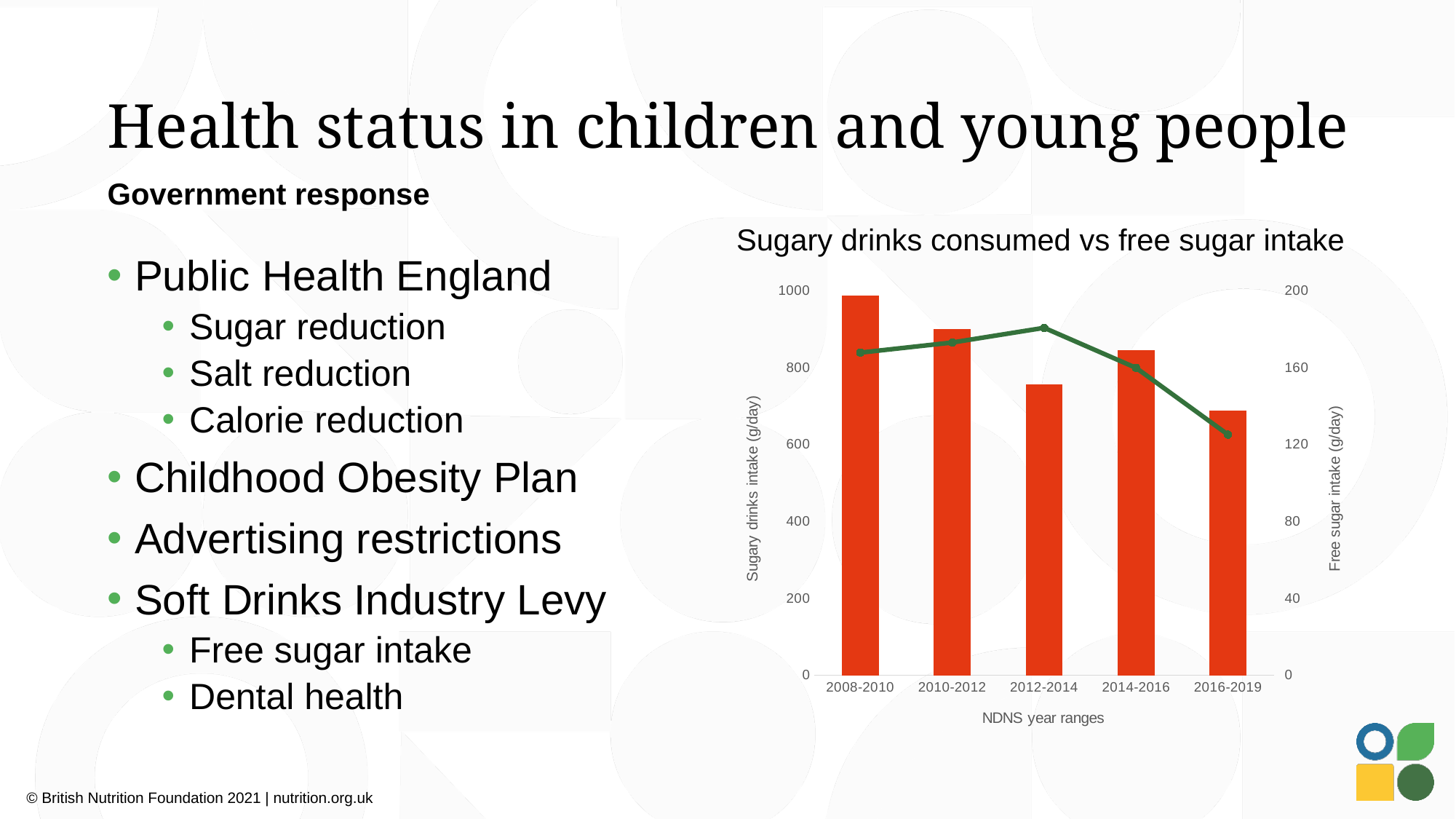
Which has the larger sugary drinks intake bar, 2010-2012 or 2012-2014? 2010-2012 Is the sugary drinks intake bar for 2008-2010 greater or less than 800 g/day? greater Does the free sugar intake line rise or fall between 2012-2014 and 2016-2019? fall What is the label of the right-hand vertical axis of the chart? Free sugar intake (g/day) Is the free sugar intake line value for 2012-2014 greater or less than 160 g/day? greater How many NDNS year ranges are shown on the x axis of the chart? 5 Which NDNS year range has the lowest sugary drinks intake bar? 2016-2019 Is the sugary drinks intake bar for 2012-2014 greater or less than 600 g/day? greater Which NDNS year range has the highest sugary drinks intake bar? 2008-2010 What is the title of the chart? Sugary drinks consumed vs free sugar intake